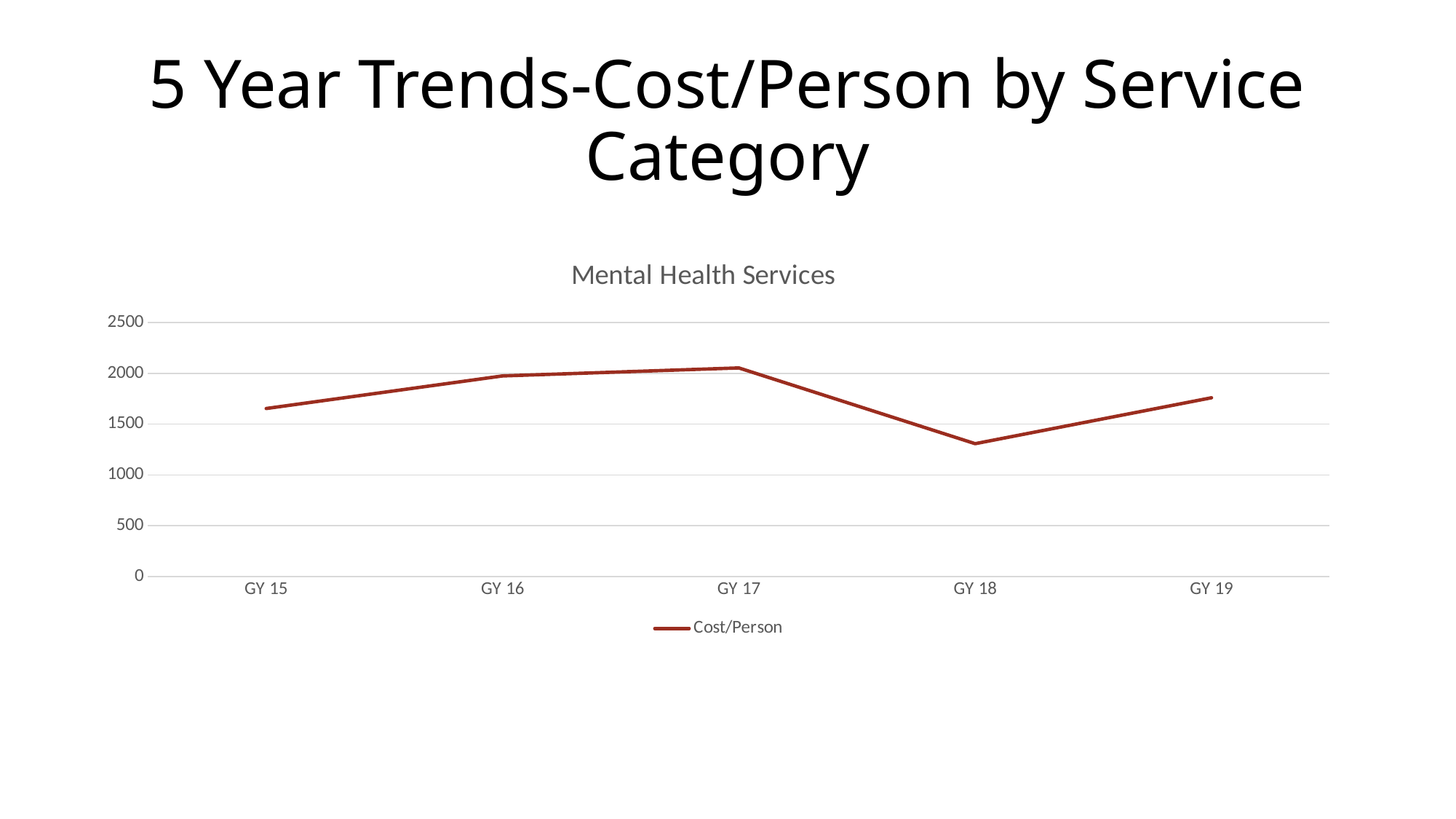
Which year has the lowest Cost/Person? GY 18 Does the Cost/Person rise or fall from GY 17 to GY 18? fall Is the Cost/Person for GY 15 greater or less than 1500? greater Is the Cost/Person for GY 19 greater or less than 2000? less Which is larger, the Cost/Person for GY 15 or for GY 18? GY 15 What is the title of the chart? Mental Health Services What kind of chart is shown on the slide? line chart Which is larger, the Cost/Person for GY 17 or for GY 19? GY 17 How many points (years) are plotted on the x axis of the chart? 5 Is the Cost/Person for GY 18 greater or less than 1500? less Which year has the highest Cost/Person? GY 17 How many series does the legend list? 1